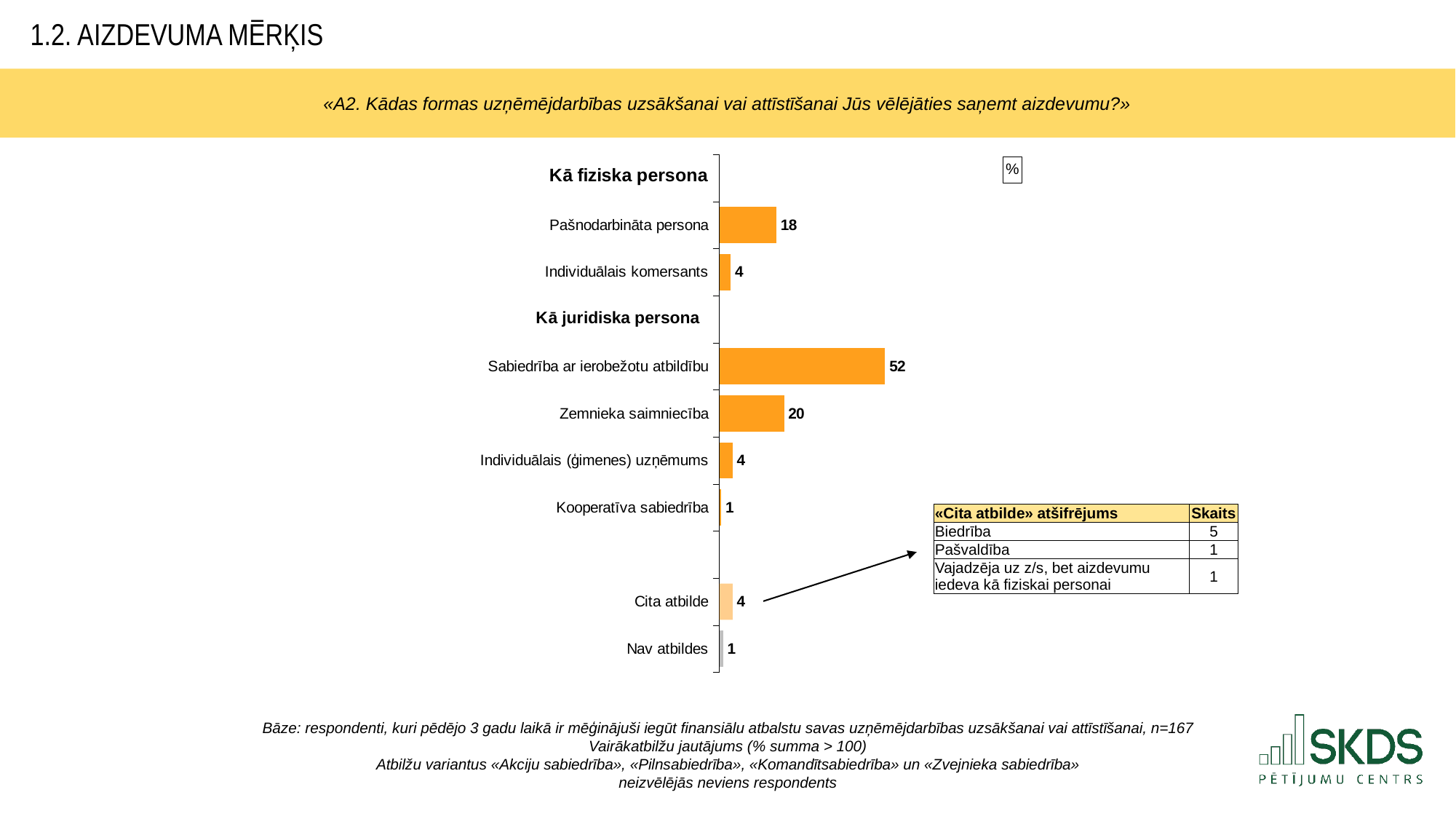
What is the difference between the values for Sabiedrība ar ierobežotu atbildību and Zemnieka saimniecība? 32 What is the difference between the values for Zemnieka saimniecība and Pašnodarbināta persona? 2 What is the value for Zemnieka saimniecība? 20 How many bars are plotted in the chart? 8 What is the value for Kooperatīva sabiedrība? 1 Which category has the highest value? Sabiedrība ar ierobežotu atbildību What is the value for Cita atbilde? 4 What kind of chart is shown on the slide? Bar chart What is the value for Sabiedrība ar ierobežotu atbildību? 52 What is the value for Pašnodarbināta persona? 18 Which is larger, the value for Pašnodarbināta persona or the value for Individuālais komersants? Pašnodarbināta persona What unit is indicated in the box at the top right of the chart? %